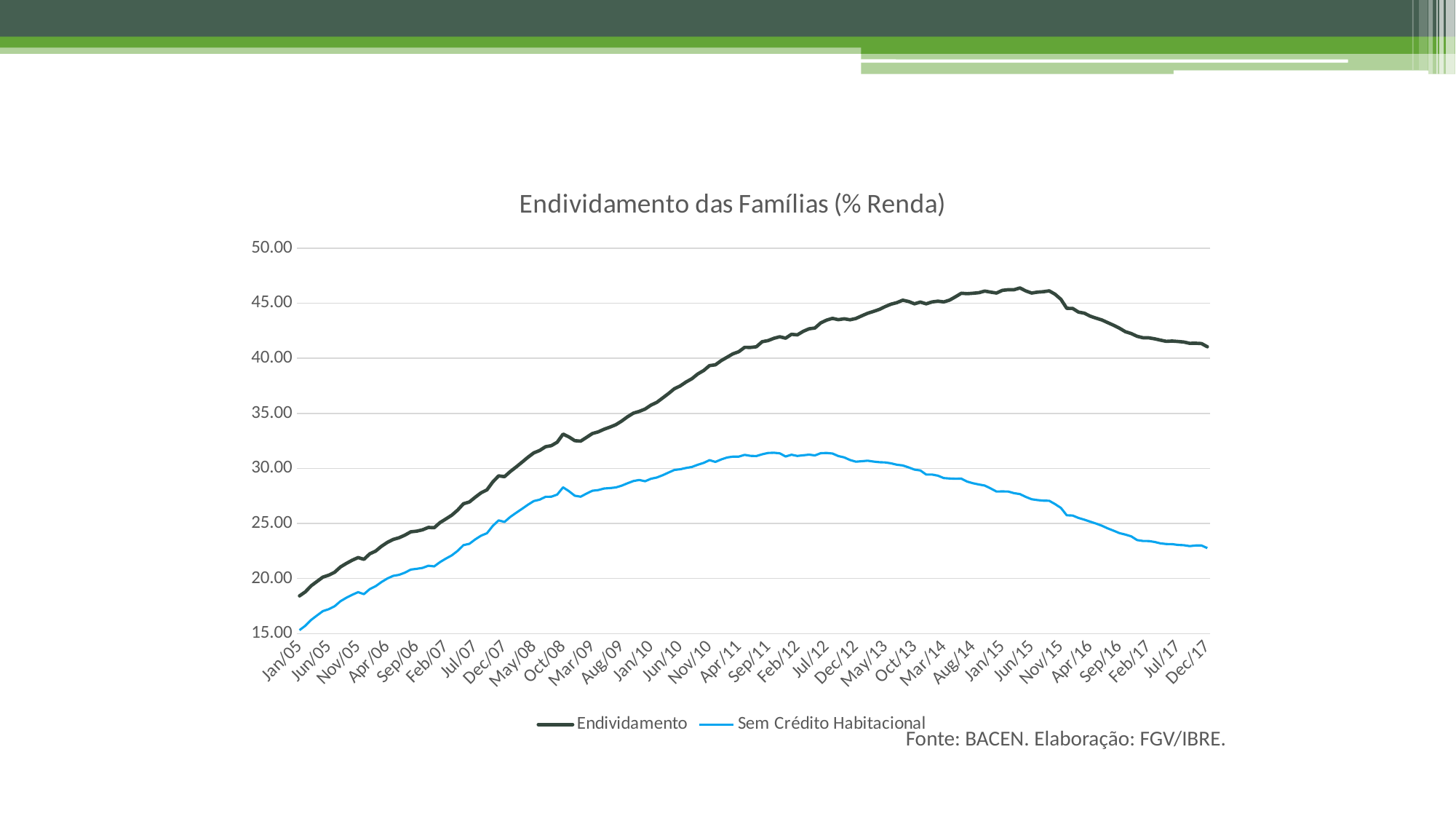
Is the value for Sem Crédito Habitacional at Jul/12 greater or less than 30.00? greater Is the value for Sem Crédito Habitacional at Jan/05 greater or less than 20.00? less How many series does the legend list? 2 Does the Endividamento series rise or fall between Jan/05 and Jan/15? rise What kind of chart is shown on the slide? line chart What are the two series named in the legend? Endividamento and Sem Crédito Habitacional What is the title of the chart? Endividamento das Famílias (% Renda) Is the value for Endividamento at Dec/17 greater or less than 45.00? less Which series has the higher value at Dec/17, Endividamento or Sem Crédito Habitacional? Endividamento